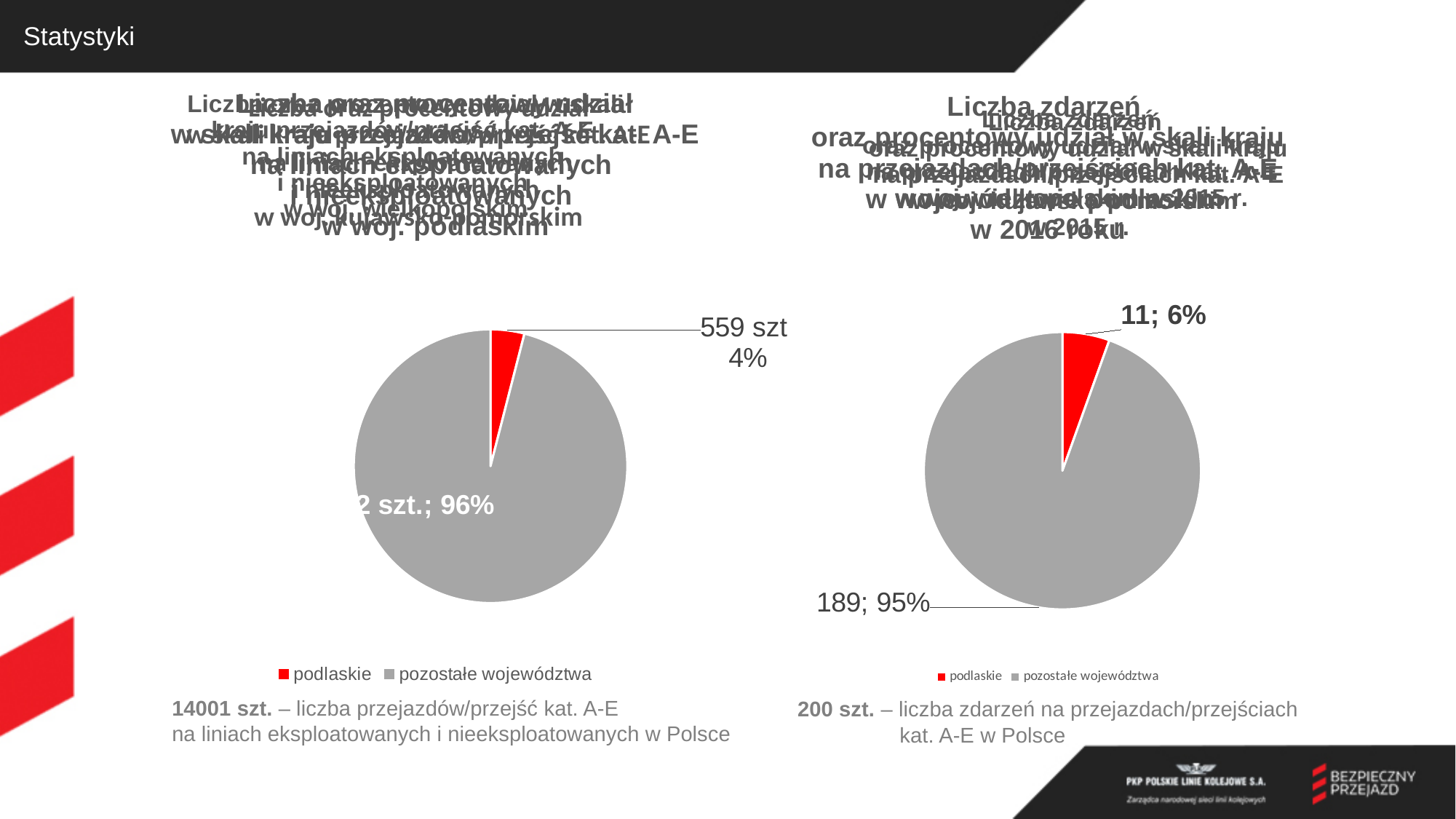
In the left pie chart, what share of the pie does podlaskie represent? 4% In the right pie chart, what share of the pie does podlaskie represent? 6% In the right pie chart, which colour represents podlaskie? red In the right pie chart, what share of the pie does pozostałe województwa represent? 95% What type of chart is the right chart on the slide? pie chart How many categories does the legend of the left pie chart list? 2 In the right pie chart, which category has the largest slice? pozostałe województwa In the right pie chart, what value is shown for pozostałe województwa? 189 In the right pie chart, what value is shown for podlaskie? 11 In the left pie chart, what value is shown for podlaskie? 559 szt What type of chart is the left chart on the slide? pie chart